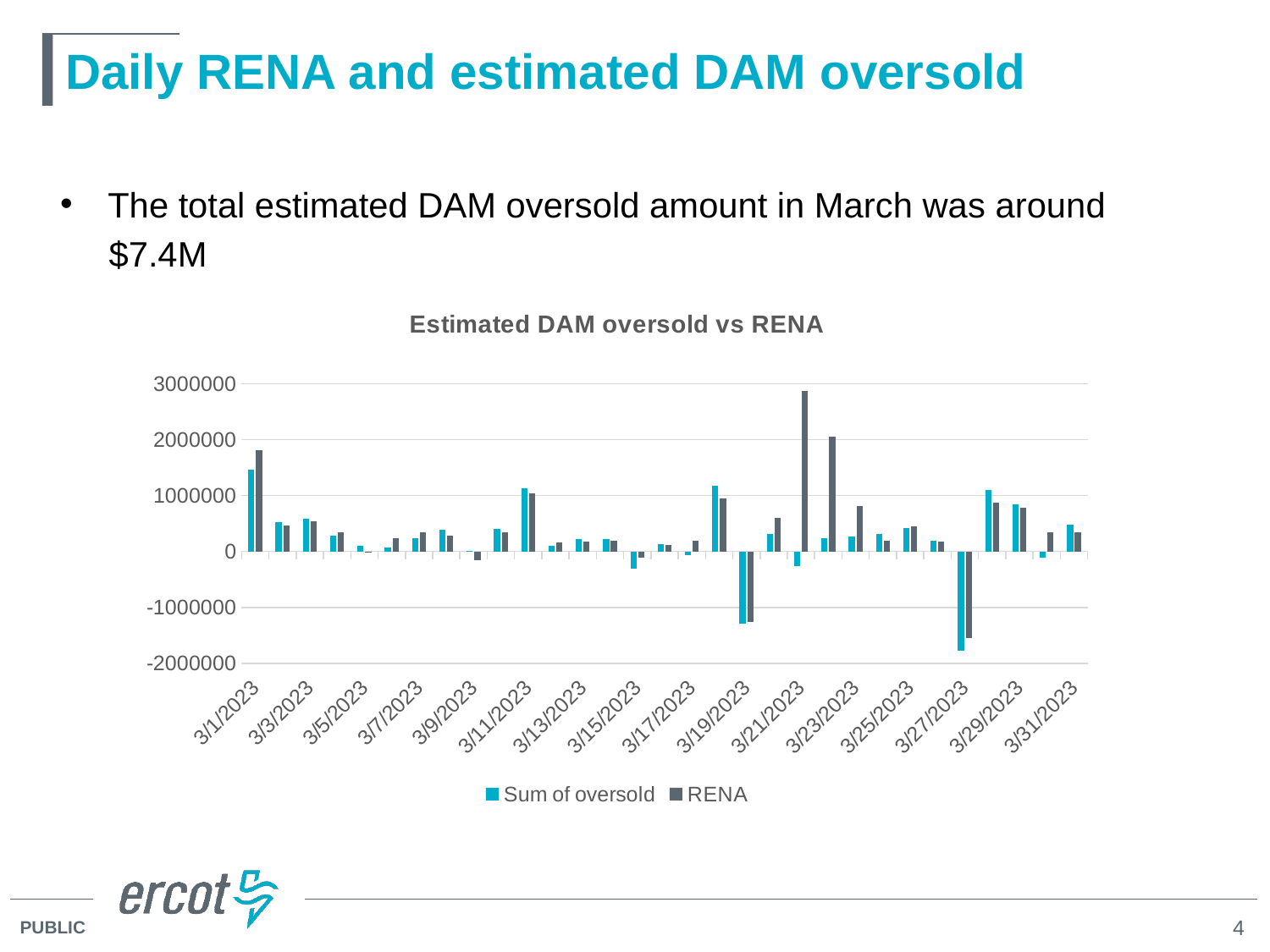
How many series does the chart legend list? 2 On which date does the RENA series reach its highest value? 3/21/2023 On 3/1/2023, which is larger: the RENA value or the Sum of oversold value? RENA On 3/21/2023, which is larger: the RENA value or the Sum of oversold value? RENA What are the two series named in the chart legend? Sum of oversold and RENA Is the Sum of oversold value for 3/1/2023 greater or less than 1000000? greater On which date does the Sum of oversold series reach its lowest value? 3/27/2023 Is the RENA value for 3/21/2023 greater or less than 2000000? greater Is the RENA value for 3/27/2023 greater or less than -1000000? less What is the title of the chart? Estimated DAM oversold vs RENA What type of chart is shown on the slide? bar chart